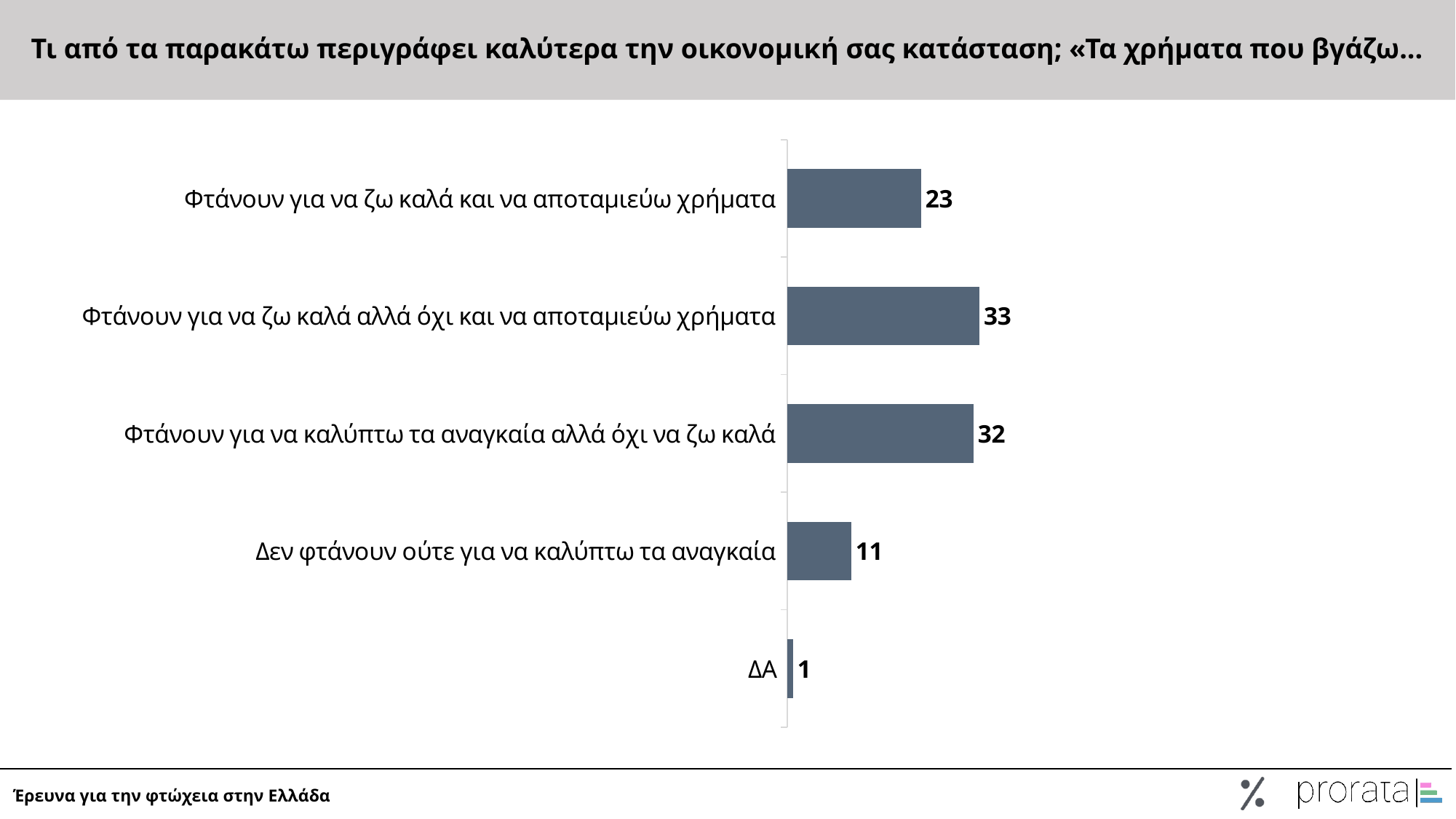
What value is shown for «ΔΑ»? 1 What value is shown for «Φτάνουν για να ζω καλά και να αποταμιεύω χρήματα»? 23 What is the difference between the values for «Φτάνουν για να ζω καλά αλλά όχι και να αποταμιεύω χρήματα» and «Φτάνουν για να καλύπτω τα αναγκαία αλλά όχι να ζω καλά»? 1 What value is shown for «Φτάνουν για να ζω καλά αλλά όχι και να αποταμιεύω χρήματα»? 33 What value is shown for «Φτάνουν για να καλύπτω τα αναγκαία αλλά όχι να ζω καλά»? 32 How many categories are shown in the chart? 5 What kind of chart is shown on the slide? Bar chart Which is larger: the value for «Φτάνουν για να ζω καλά και να αποταμιεύω χρήματα» or the value for «Δεν φτάνουν ούτε για να καλύπτω τα αναγκαία»? Φτάνουν για να ζω καλά και να αποταμιεύω χρήματα Which category has the lowest value? ΔΑ Which category has the highest value? Φτάνουν για να ζω καλά αλλά όχι και να αποταμιεύω χρήματα What value is shown for «Δεν φτάνουν ούτε για να καλύπτω τα αναγκαία»? 11 What is the difference between the values for «Φτάνουν για να ζω καλά και να αποταμιεύω χρήματα» and «Δεν φτάνουν ούτε για να καλύπτω τα αναγκαία»? 12